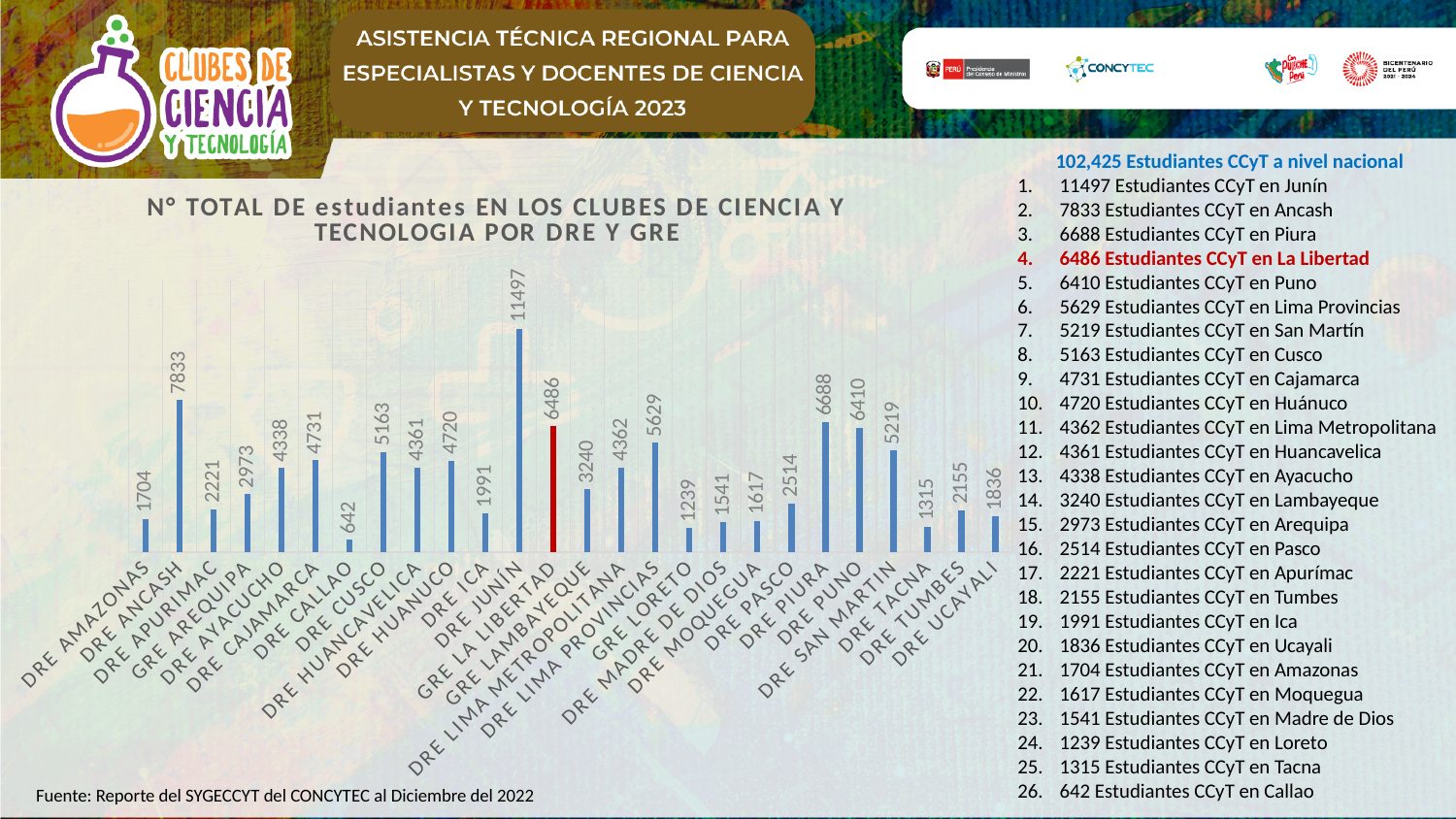
Which category has the highest value? DRE JUNIN What is the value for DRE CALLAO? 642 What is the value for DRE JUNIN? 11497 Which category has the lowest value? DRE CALLAO How many categories are shown on the x axis? 26 Which is larger, the value for DRE PIURA or the value for DRE PUNO? DRE PIURA What is the difference between the values for DRE JUNIN and DRE ANCASH? 3664 What is the difference between the values for DRE PIURA and DRE PUNO? 278 What kind of chart is shown on the slide? Bar chart Which bar is coloured red instead of blue? GRE LA LIBERTAD What is the value for GRE LORETO? 1239